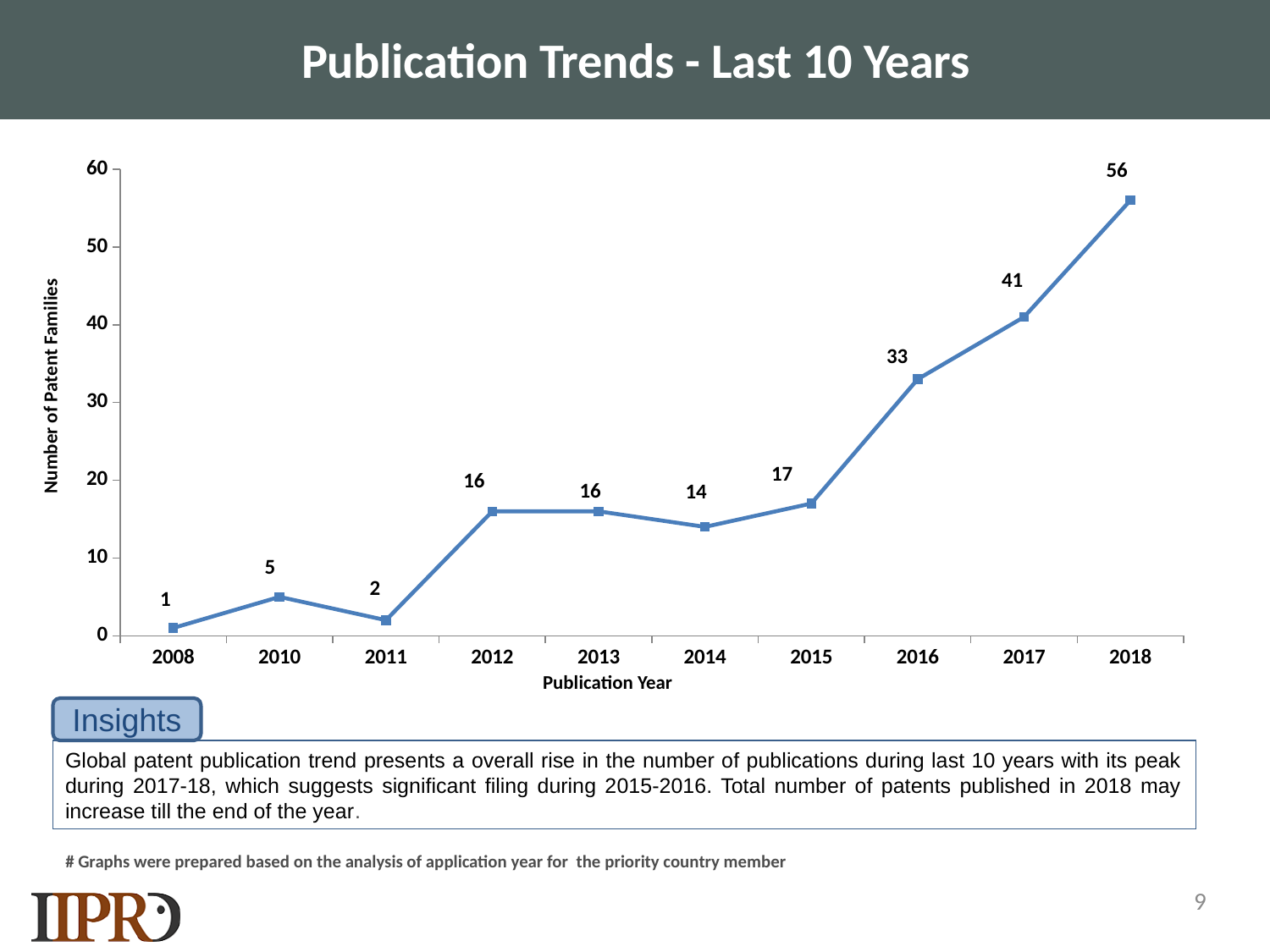
Which publication year has the lowest number of patent families? 2008 How many patent families were published in 2016? 33 Which publication year has the highest number of patent families? 2018 What is the number of patent families for 2012? 16 What is the label of the y axis? Number of Patent Families What is the overall trend in the number of patent families from 2008 to 2018? rising How many publication years are plotted on the x axis? 10 What is the difference in the number of patent families between 2016 and 2015? 16 What is the label of the x axis? Publication Year Which year has more patent families, 2014 or 2015? 2015 What is the difference in the number of patent families between 2018 and 2017? 15 What kind of chart is shown on the slide? line chart